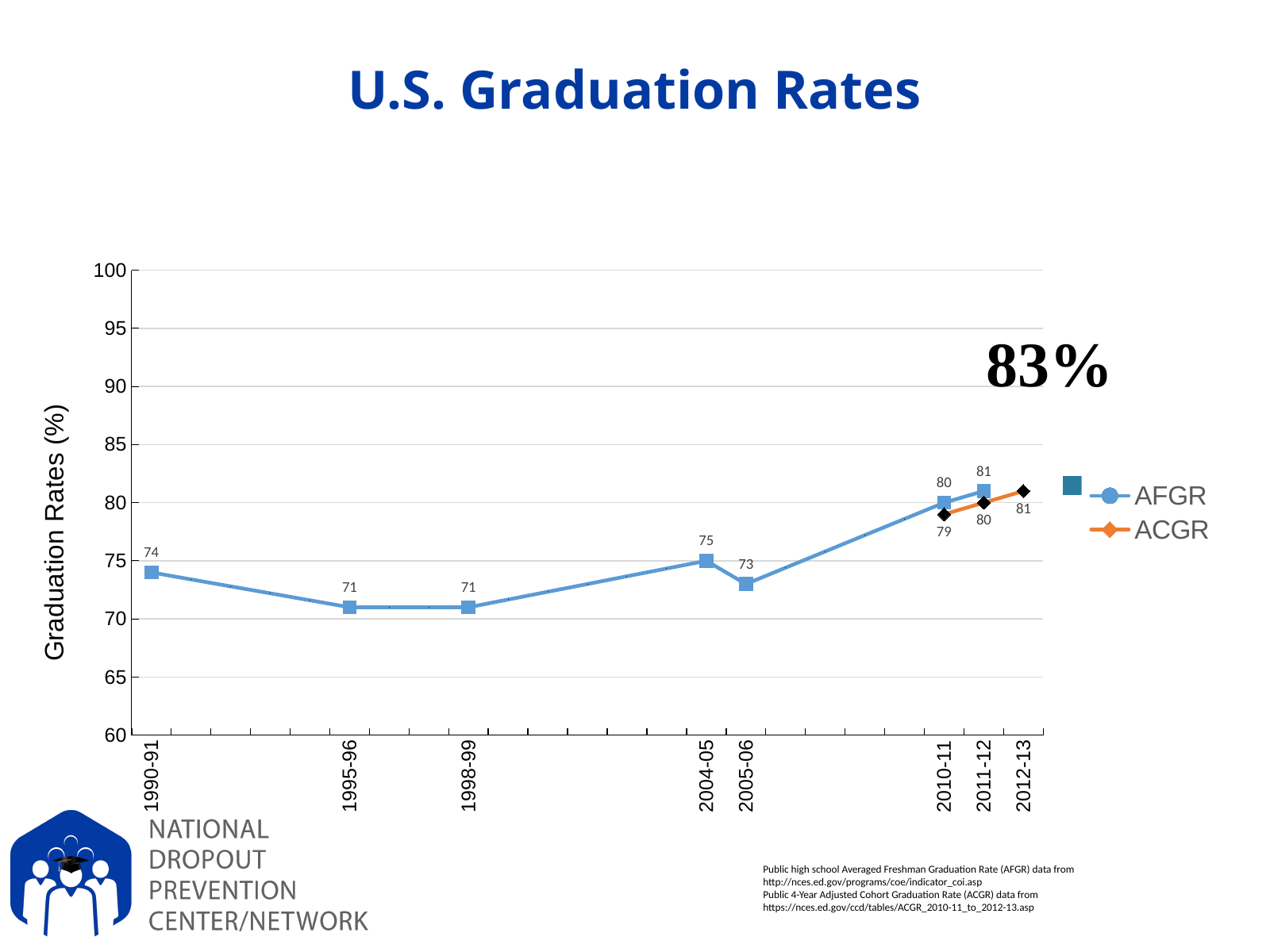
What is the AFGR value for 1990-91? 74 How many series does the legend list? 2 Which year has the lowest AFGR value? 1995-96 and 1998-99 (71) What is the ACGR value for 2012-13? 81 What is the difference between the AFGR value in 2011-12 and the AFGR value in 1990-91? 7 Which year has the highest AFGR value? 2011-12 What is the ACGR value for 2010-11? 79 How many data points are plotted for the ACGR series? 3 What is the label of the y axis? Graduation Rates (%) What is the AFGR value for 2005-06? 73 In 2010-11, which series has the larger value, AFGR or ACGR? AFGR What type of chart is shown on the slide? line chart